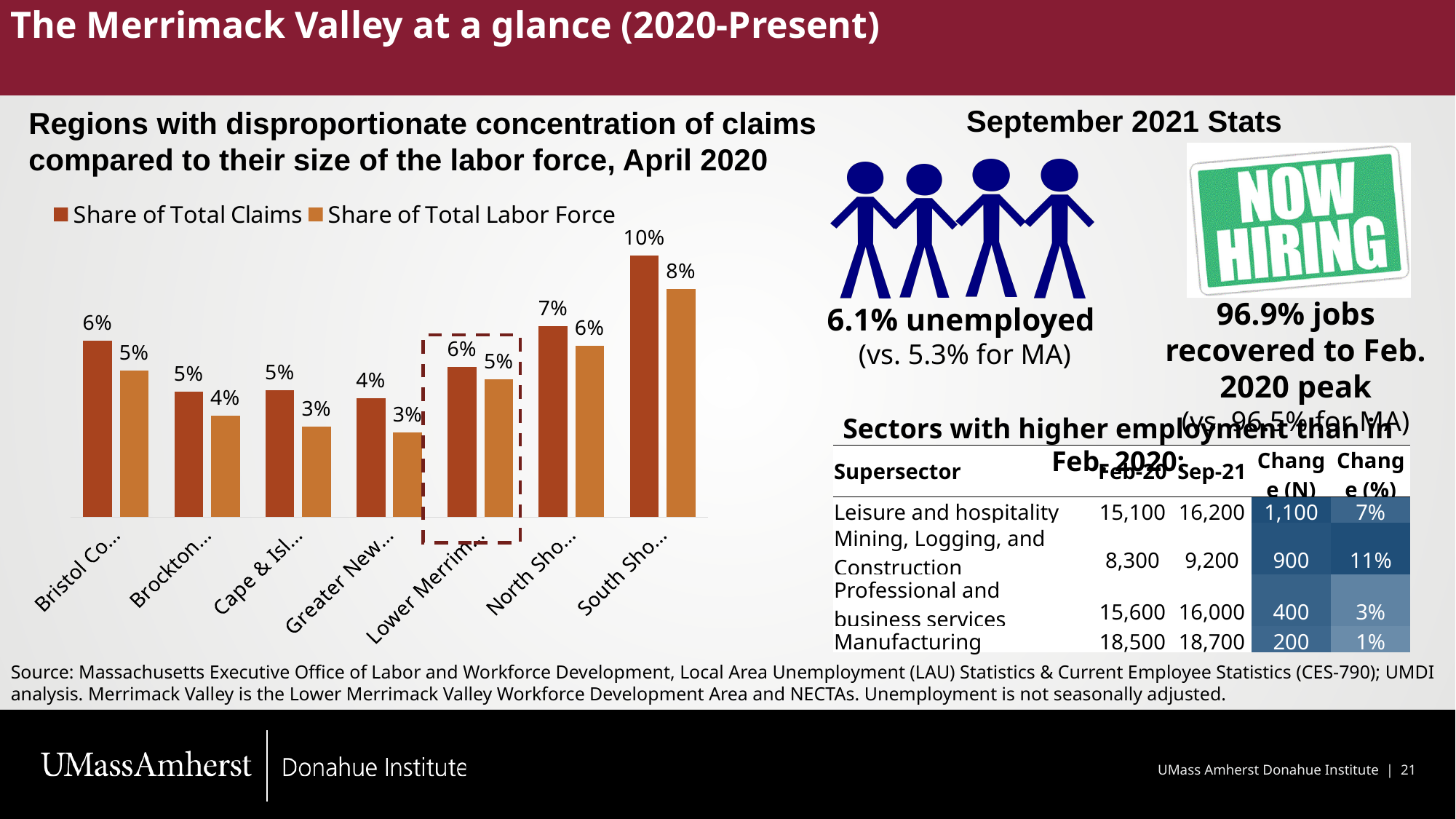
What kind of chart is shown on the left of the slide? bar chart What is the Share of Total Claims for the South Sho... region? 10% Which region has the highest Share of Total Claims? South Sho... Which region's bars are highlighted with a dashed box on the bar chart? Lower Merrim... How many regions (categories) are plotted on the bar chart? 7 Which region has the lowest Share of Total Claims? Greater New... What are the two legend entries of the bar chart? Share of Total Claims; Share of Total Labor Force What is the Share of Total Labor Force for the Lower Merrim... region? 5% How many series does the legend of the bar chart list? 2 What is the Share of Total Claims for the North Sho... region? 7% Which is larger for the Cape & Isl... region: Share of Total Claims or Share of Total Labor Force? Share of Total Claims What is the difference between Share of Total Claims and Share of Total Labor Force for the South Sho... region? 2%